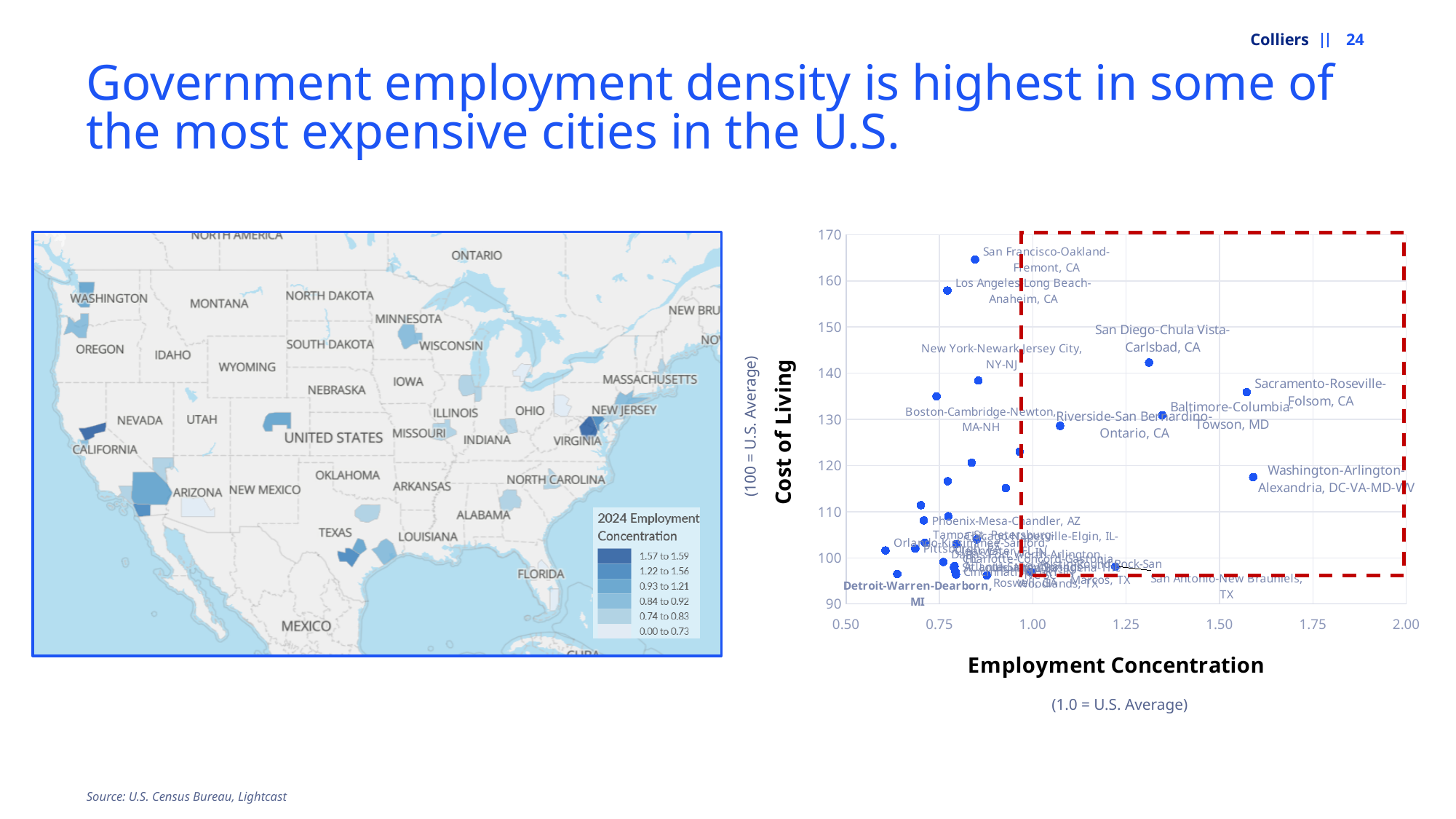
What is the title of the x axis of the scatter chart? Employment Concentration In the scatter chart, is the employment concentration for Los Angeles-Long Beach-Anaheim, CA greater or less than 1.00? less In the scatter chart, which metro area has the highest cost of living? San Francisco-Oakland-Fremont, CA What kind of chart is shown on the right side of the slide? scatter chart In the scatter chart, is the employment concentration for Sacramento-Roseville-Folsom, CA greater or less than 1.50? greater In the scatter chart, is the cost of living for Washington-Arlington-Alexandria, DC-VA-MD-WV greater or less than 120? less In the scatter chart, which has the higher employment concentration: Washington-Arlington-Alexandria, DC-VA-MD-WV or Boston-Cambridge-Newton, MA-NH? Washington-Arlington-Alexandria, DC-VA-MD-WV In the map's legend, what is the highest range of 2024 Employment Concentration shown? 1.57 to 1.59 In the scatter chart, which has the higher cost of living: San Diego-Chula Vista-Carlsbad, CA or Washington-Arlington-Alexandria, DC-VA-MD-WV? San Diego-Chula Vista-Carlsbad, CA In the scatter chart, which has the higher cost of living: San Francisco-Oakland-Fremont, CA or Los Angeles-Long Beach-Anaheim, CA? San Francisco-Oakland-Fremont, CA